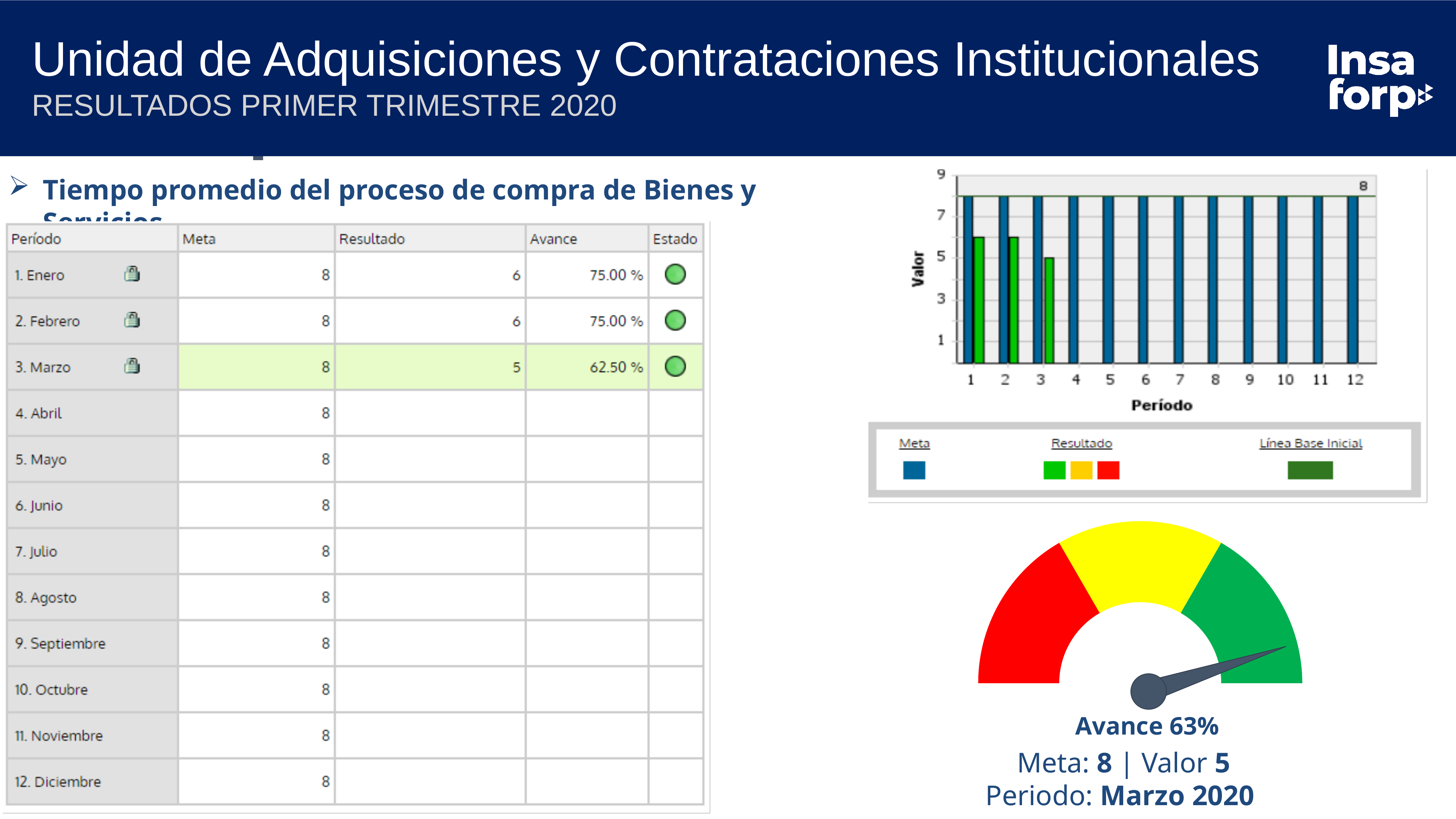
What type of chart is shown at the top right of the slide? bar chart In the bar chart at the top right, do the Resultado bars rise or fall from period 1 to period 3? fall In the bar chart at the top right, what is the Meta value shown by the data label? 8 In the bar chart at the top right, is the Resultado value for period 2 greater or less than 7? less In the bar chart at the top right, what is the Resultado value for period 3? 5 In the bar chart at the top right, what is the Resultado value for period 1? 6 In the bar chart at the top right, what is the difference between the Meta and the Resultado for period 3? 3 In the bar chart at the top right, which is larger for period 3, the Meta bar or the Resultado bar? Meta In the bar chart at the top right, how many series does the legend list? 3 In the bar chart at the top right, what is the label of the y axis? Valor What Avance percentage is shown below the gauge chart at the bottom right? 63% In the bar chart at the top right, how many periods are shown on the x axis? 12